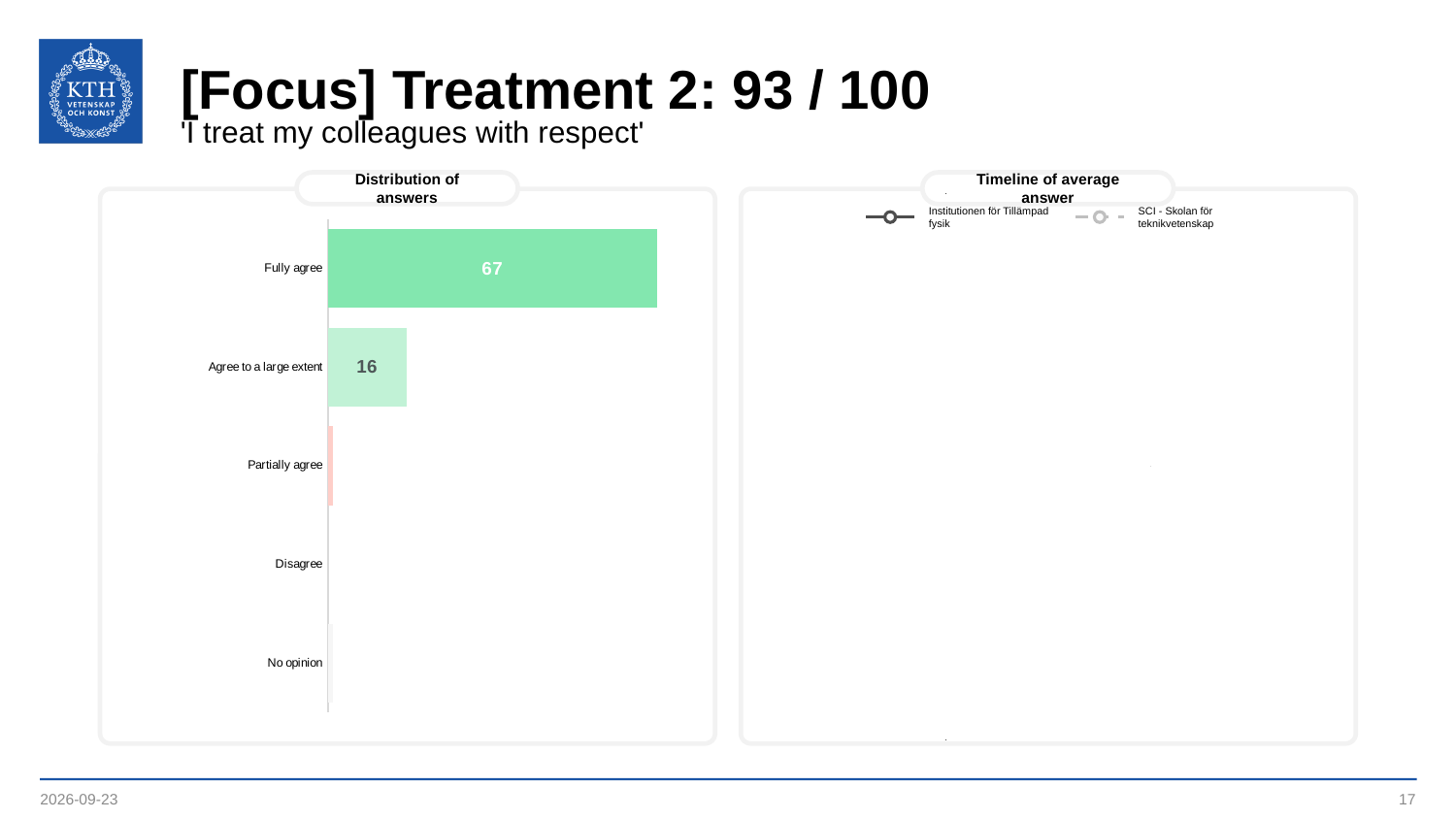
What kind of chart is the 'Distribution of answers' chart? Bar chart In the 'Distribution of answers' chart, what is the value for 'Agree to a large extent'? 16 How many categories are shown in the 'Distribution of answers' chart? 5 In the 'Timeline of average answer' chart, what is the name of the first series in the legend? Institutionen för Tillämpad fysik In the 'Distribution of answers' chart, which is larger: 'Agree to a large extent' or 'Partially agree'? Agree to a large extent In the 'Timeline of average answer' chart, what is the name of the second series in the legend? SCI - Skolan för teknikvetenskap In the 'Distribution of answers' chart, what is the difference between the values for 'Fully agree' and 'Agree to a large extent'? 51 In the 'Distribution of answers' chart, what is the value for 'Fully agree'? 67 How many series does the legend of the 'Timeline of average answer' chart list? 2 In the 'Distribution of answers' chart, which is larger: 'Fully agree' or 'Agree to a large extent'? Fully agree In the 'Distribution of answers' chart, which category has the highest value? Fully agree